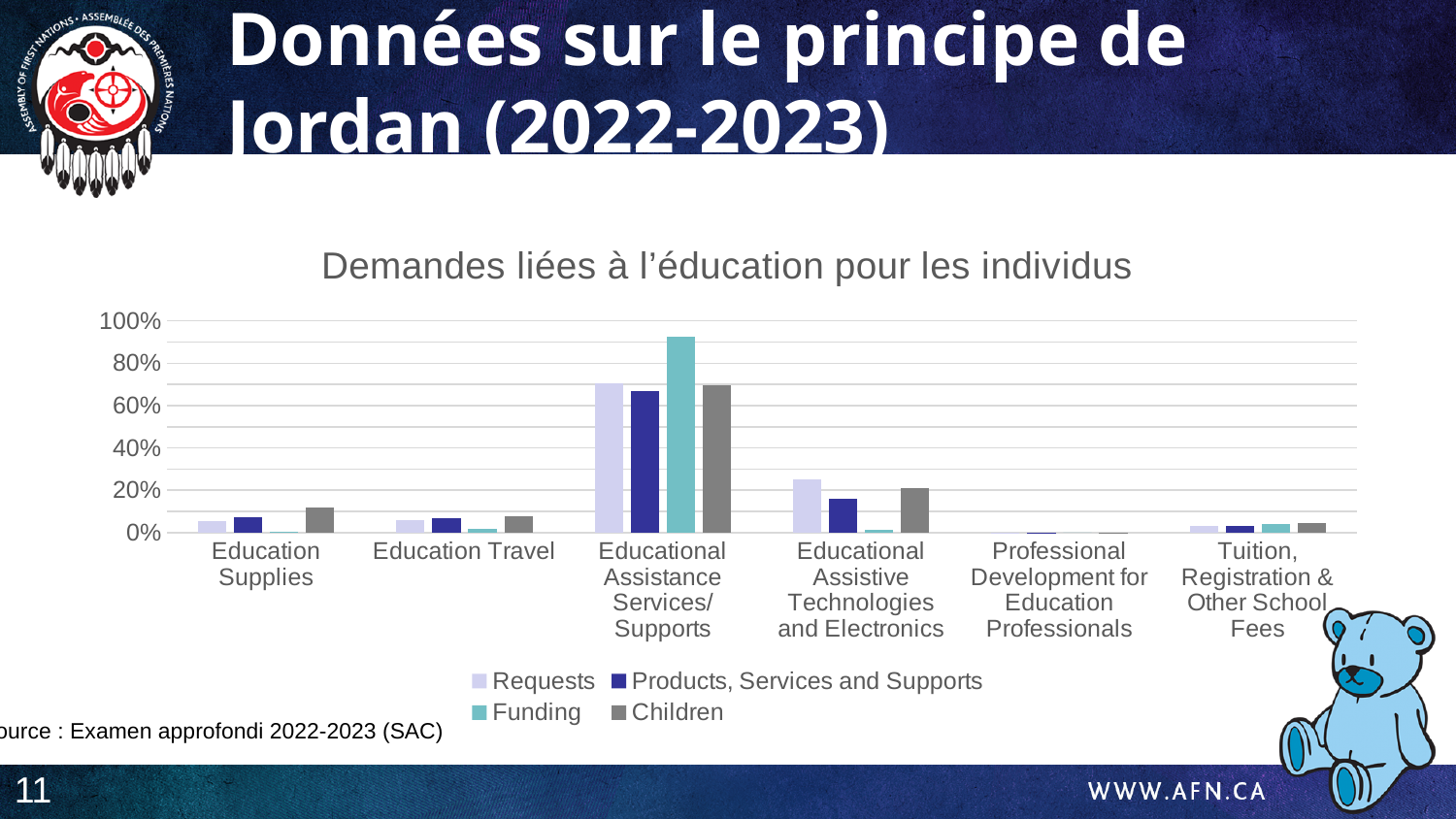
How many series does the chart's legend list? 4 Which category has the highest value for the Requests series? Educational Assistance Services/Supports Within Educational Assistance Services/Supports, which series has the larger value: Funding or Requests? Funding Is the Requests value for Educational Assistive Technologies and Electronics greater or less than 40%? less What kind of chart is shown on the slide? bar chart Within Educational Assistive Technologies and Electronics, which series has the larger value: Requests or Funding? Requests Which category has the highest value for the Funding series? Educational Assistance Services/Supports Is the Funding value for Educational Assistance Services/Supports greater or less than 80%? greater How many categories are shown on the x axis of the chart? 6 Which category has the lowest values across all series? Professional Development for Education Professionals What is the title of the chart? Demandes liées à l'éducation pour les individus Is the Children value for Education Supplies greater or less than 20%? less